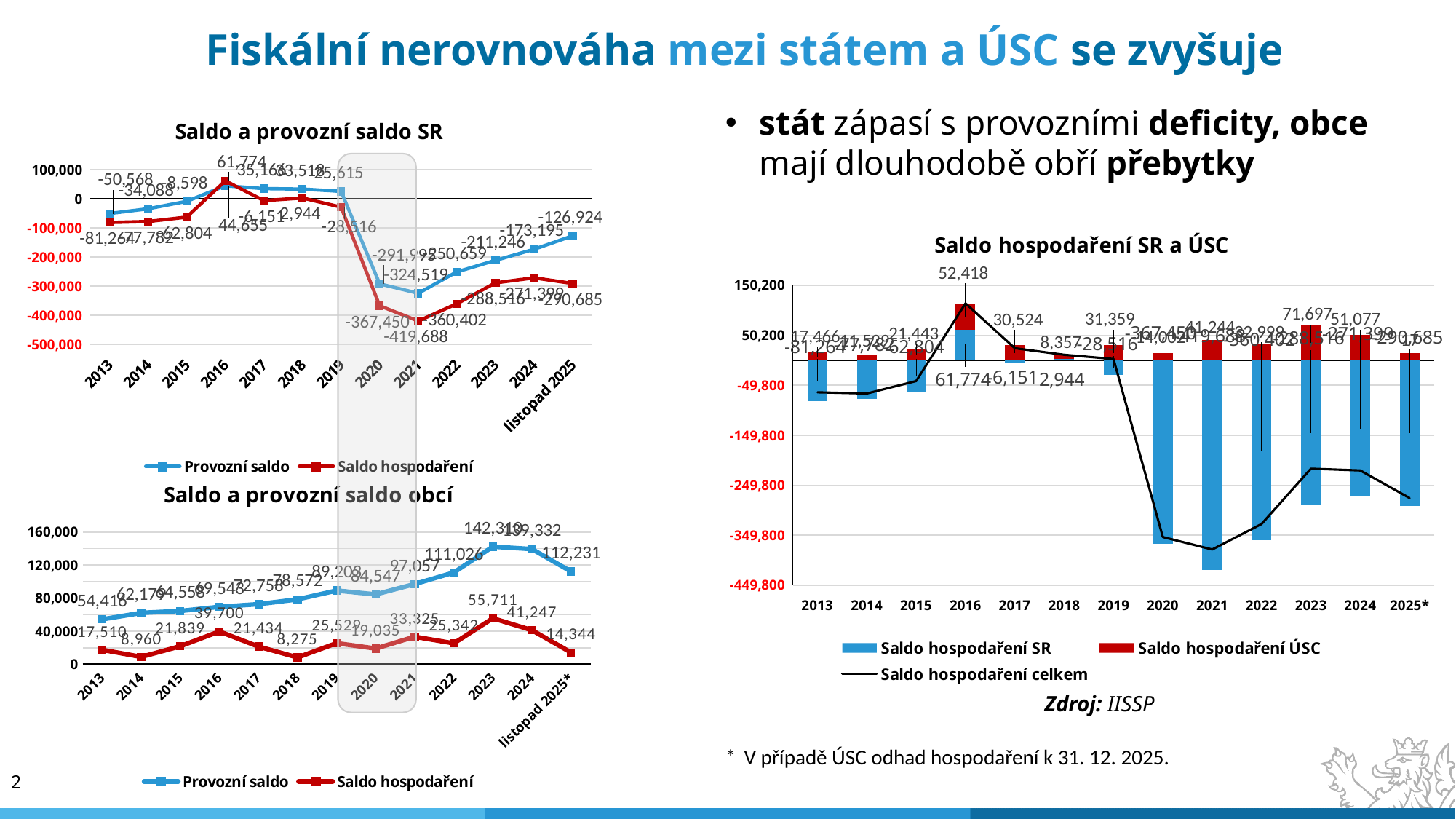
In the chart 'Saldo hospodaření SR a ÚSC', how many years are shown on the x axis? 13 In the chart 'Saldo a provozní saldo SR', which year has the larger Provozní saldo, 2020 or 2021? 2020 In the chart 'Saldo hospodaření SR a ÚSC', is the value of Saldo hospodaření celkem for 2021 greater or less than -349,800? less In the chart 'Saldo a provozní saldo obcí', what is the Provozní saldo for 2023? 142,310 In the chart 'Saldo hospodaření SR a ÚSC', how many series does the legend list? 3 In the chart 'Saldo hospodaření SR a ÚSC', which year has the lowest Saldo hospodaření SR? 2021 In the chart 'Saldo hospodaření SR a ÚSC', what is the value of Saldo hospodaření SR for 2021? -419,688 In the chart 'Saldo hospodaření SR a ÚSC', what is the value of Saldo hospodaření ÚSC for 2023? 71,697 What kind of chart is 'Saldo a provozní saldo SR'? line chart In the chart 'Saldo hospodaření SR a ÚSC', which year has the highest Saldo hospodaření ÚSC? 2023 In the chart 'Saldo a provozní saldo obcí', which year has the highest Provozní saldo? 2023 In the chart 'Saldo a provozní saldo obcí', what is the difference between Provozní saldo and Saldo hospodaření in 2023? 86,599